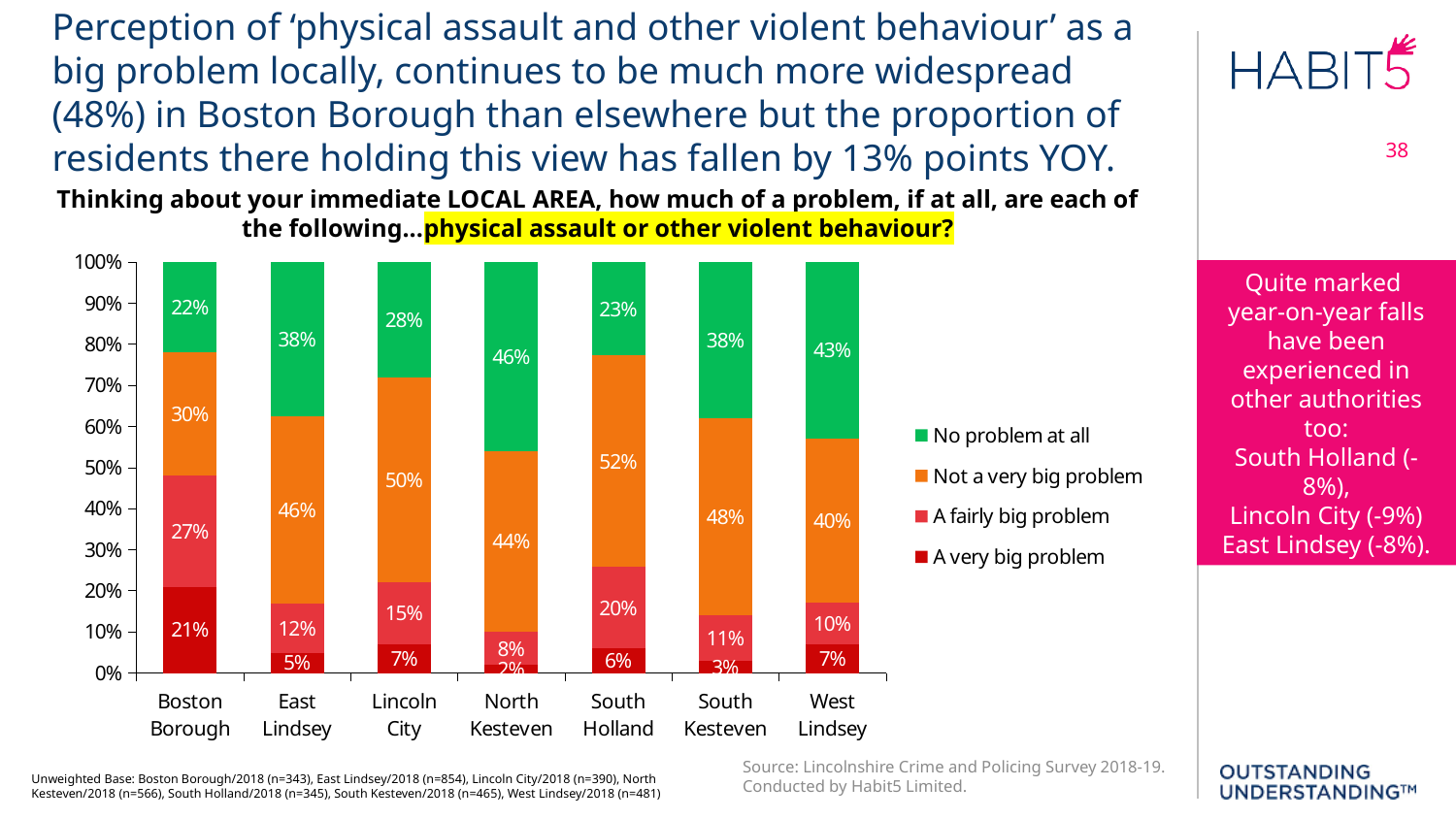
Which area has the lowest 'A very big problem' percentage? North Kesteven What is the 'No problem at all' value for North Kesteven? 46% Which area has the highest 'A very big problem' percentage? Boston Borough What is the 'A fairly big problem' value for West Lindsey? 10% How many areas are shown on the x axis of the chart? 7 What is the combined total of 'A very big problem' and 'A fairly big problem' for Boston Borough? 48% What percentage of Boston Borough residents said physical assault or other violent behaviour is 'A very big problem'? 21% What is the difference between the 'A fairly big problem' values for Boston Borough and East Lindsey? 15 percentage points Which is larger: the 'No problem at all' value for West Lindsey or for Lincoln City? West Lindsey What is the 'Not a very big problem' value for South Holland? 52% How many series does the legend list? 4 What kind of chart is shown on the slide? Stacked bar chart